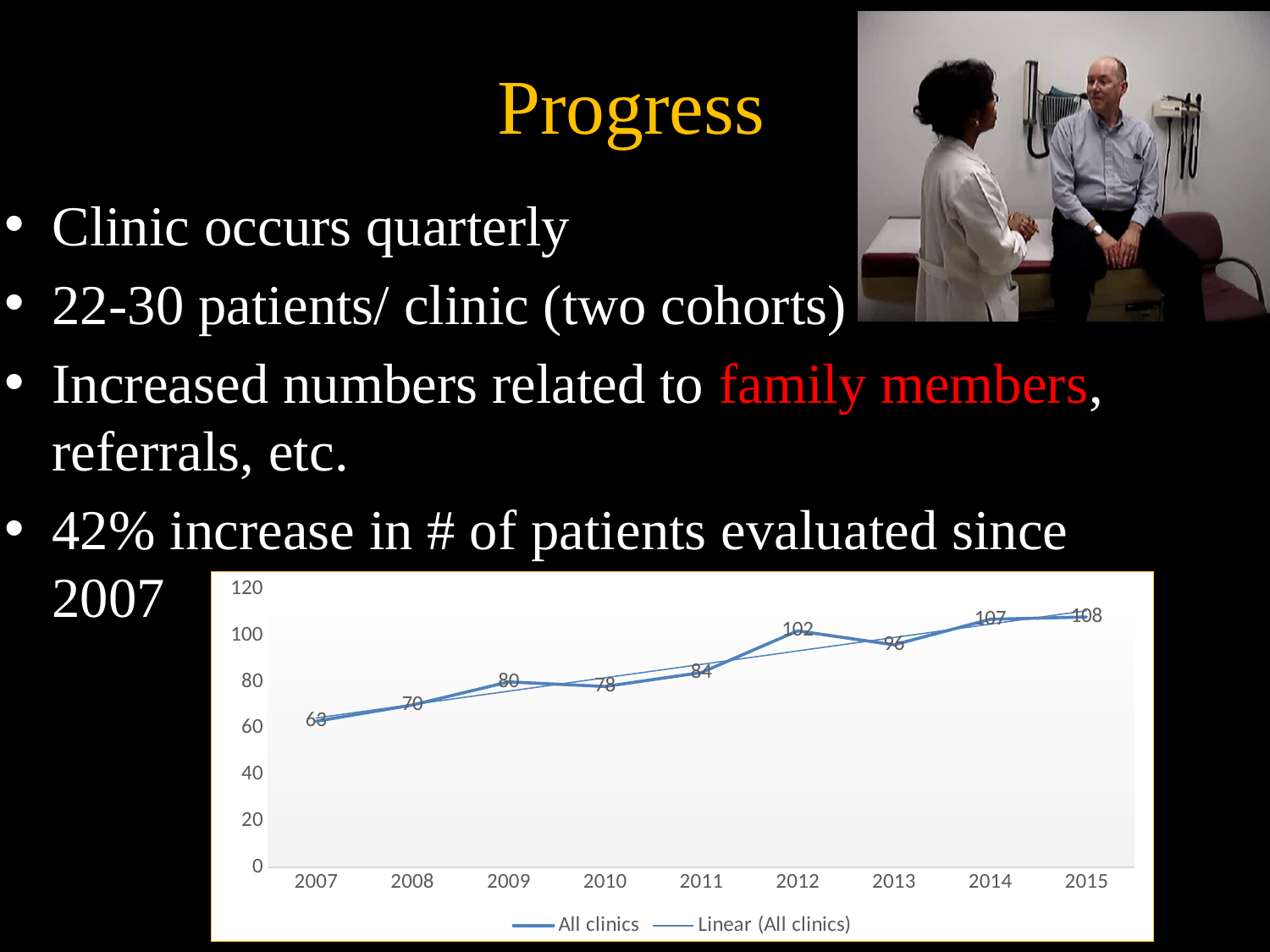
What is the value for All clinics in 2013? 96 What is the value for All clinics in 2009? 80 What is the value for All clinics in 2012? 102 What is the value for All clinics in 2015? 108 Which year has the lowest value for All clinics? 2007 Do the All clinics values generally rise or fall from 2007 to 2015? Rise Which year has the highest value for All clinics? 2015 How many years are plotted on the x axis? 9 What kind of chart is shown on the slide? Line chart Which year has the larger All clinics value, 2009 or 2010? 2009 How many series does the legend list? 2 What is the difference between the All clinics values for 2012 and 2011? 18